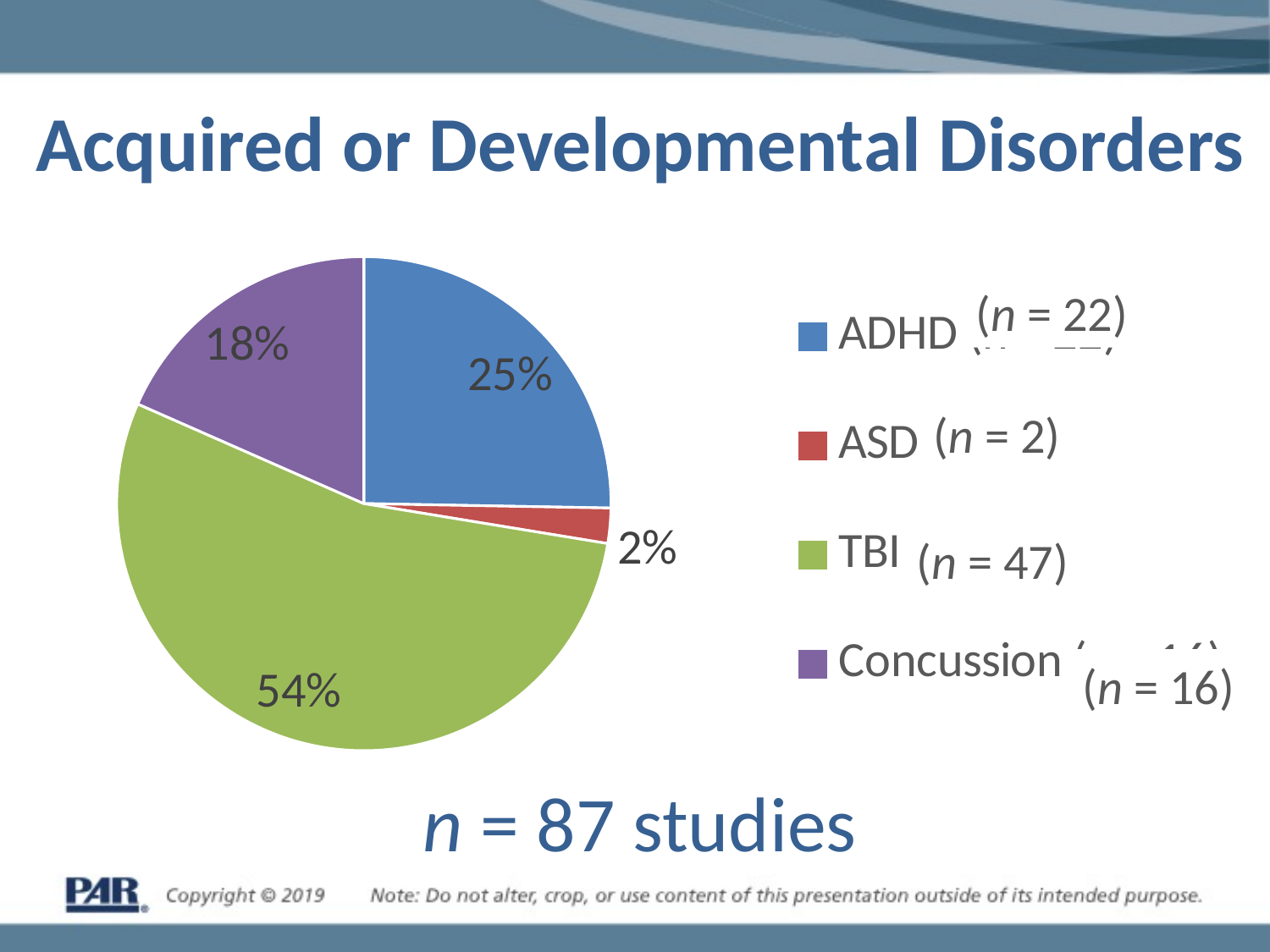
Which slice is larger, ADHD or Concussion? ADHD Which category has the largest slice of the pie? TBI How many studies does the chart represent in total, according to the text below it? 87 What share of the pie does ASD represent? 2% Which category has the smallest slice of the pie? ASD What share of the pie does Concussion represent? 18% What share of the pie does ADHD represent? 25% What colour is the TBI slice of the pie? Green What is the difference in percentage points between the TBI and ADHD slices? 29 How many categories are shown in the pie chart? 4 What share of the pie does TBI represent? 54% What kind of chart is shown on the slide? Pie chart